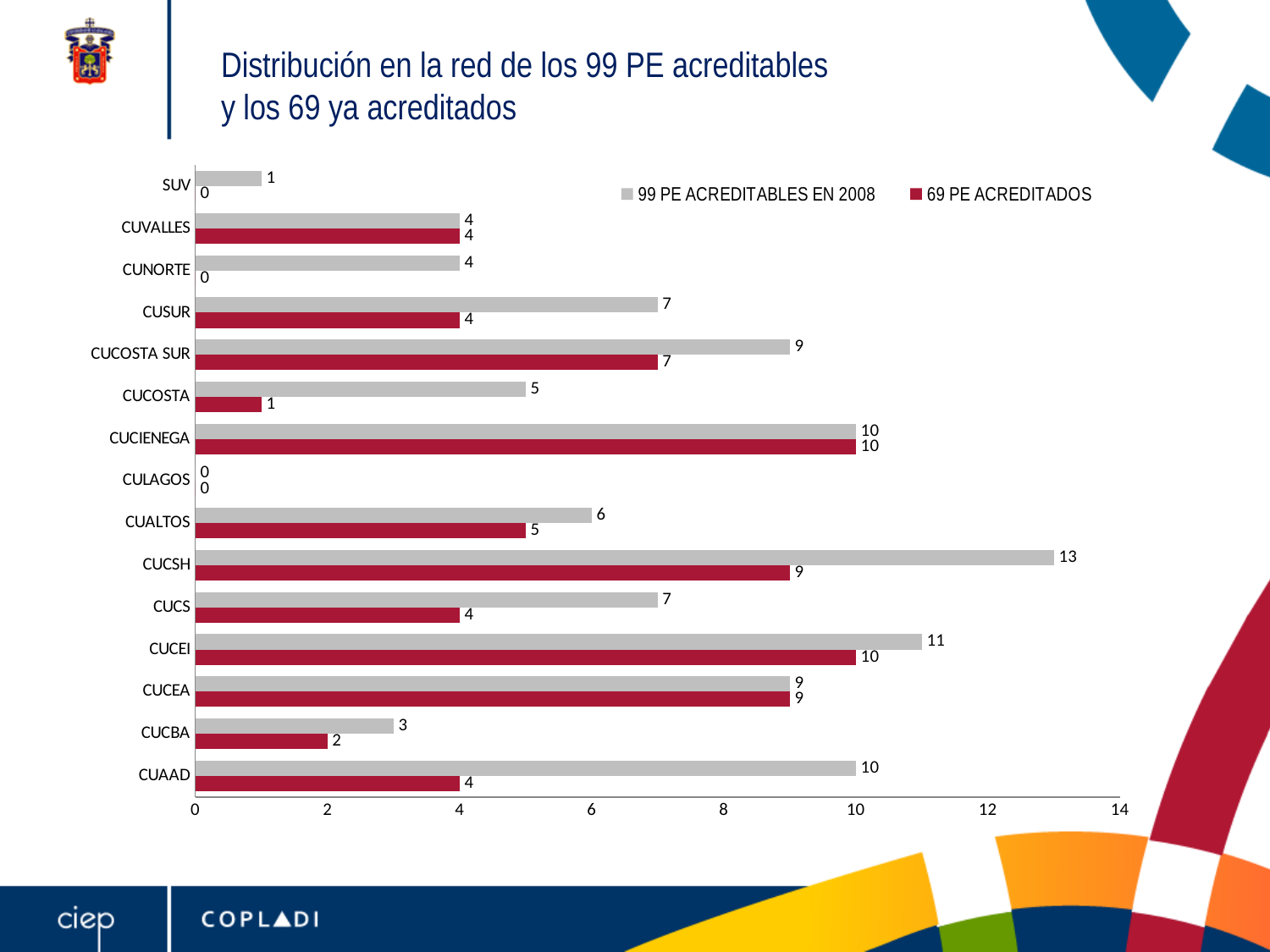
What is the difference between '99 PE ACREDITABLES EN 2008' and '69 PE ACREDITADOS' for CUAAD? 6 What is the value of '69 PE ACREDITADOS' for CUCOSTA SUR? 7 Which is larger for CUCEI: '99 PE ACREDITABLES EN 2008' or '69 PE ACREDITADOS'? 99 PE ACREDITABLES EN 2008 What type of chart is shown on the slide? bar chart What colour are the bars for the '69 PE ACREDITADOS' series? red What is the value of '99 PE ACREDITABLES EN 2008' for CUCSH? 13 How many categories (centers) are shown on the chart? 15 Is the value of '99 PE ACREDITABLES EN 2008' for CUCEI greater or less than 10? greater Which center has the highest value for '99 PE ACREDITABLES EN 2008'? CUCSH How many series does the legend list? 2 Which center has the lowest value for '99 PE ACREDITABLES EN 2008'? CULAGOS What is the value of '69 PE ACREDITADOS' for CUAAD? 4